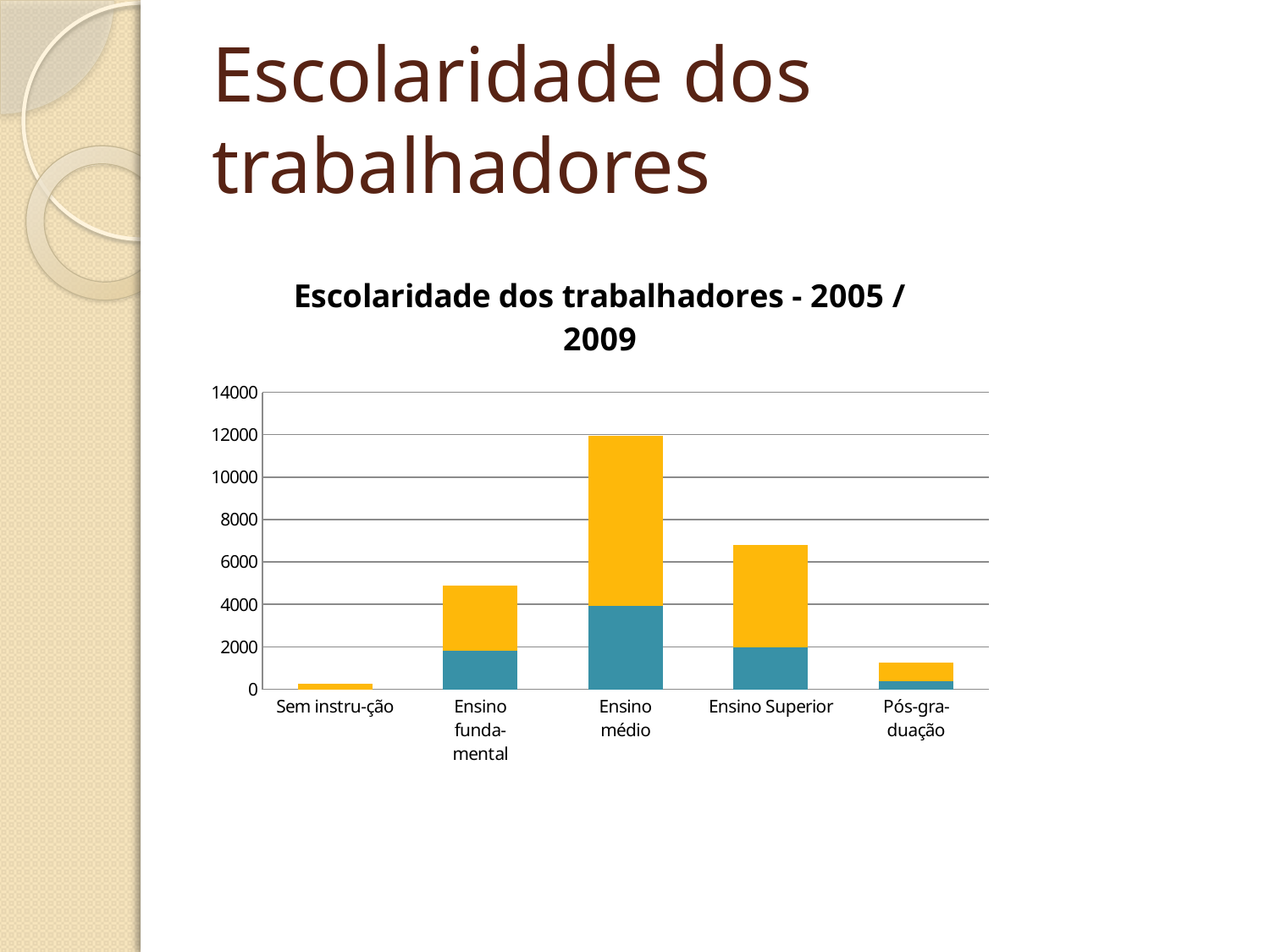
Which has the larger total stacked bar, Ensino Superior or Ensino fundamental? Ensino Superior Is the total stacked bar for Ensino Superior greater or less than 6000? greater Which category has the shortest stacked bar? Sem instrução What is the title of the chart? Escolaridade dos trabalhadores - 2005 / 2009 Is the total stacked bar for Ensino fundamental greater or less than 6000? less Is the total stacked bar for Ensino médio greater or less than 10000? greater Do the stacked bar totals rise or fall from Ensino médio to Pós-graduação along the x axis? fall What kind of chart is shown on the slide? Stacked bar chart Which category has the tallest stacked bar? Ensino médio Which has the larger total stacked bar, Ensino médio or Ensino Superior? Ensino médio How many education categories are shown on the x axis? 5